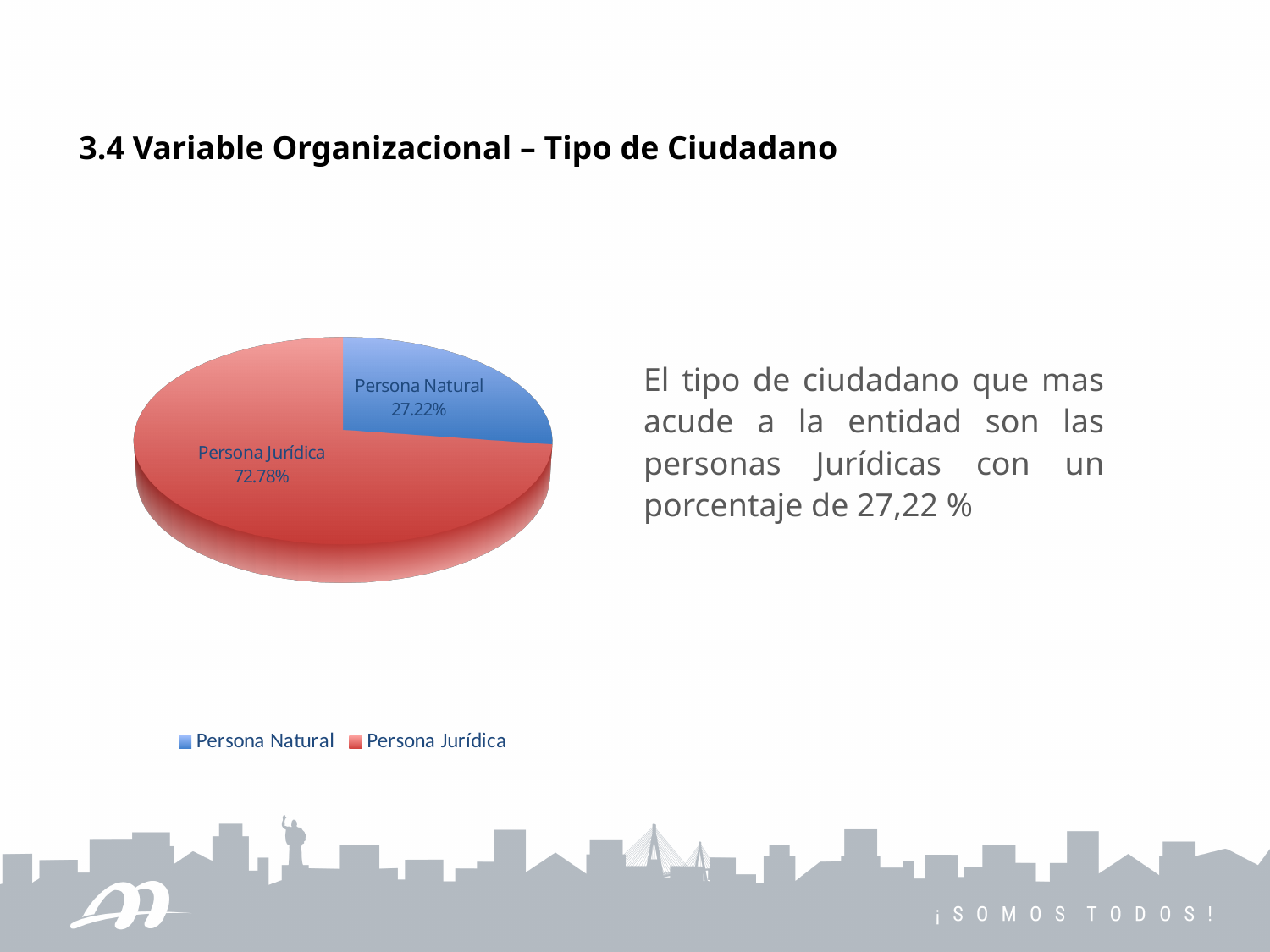
What kind of chart is shown on the slide? Pie chart What share of the pie does Persona Natural represent? 27.22% Which category has the smallest share of the pie? Persona Natural What percentage does the Persona Natural slice show? 27.22% What colour is the Persona Natural slice? Blue Which is larger, the share for Persona Natural or the share for Persona Jurídica? Persona Jurídica Which category has the largest share of the pie? Persona Jurídica What percentage does the Persona Jurídica slice show? 72.78% What is the difference in percentage points between Persona Jurídica and Persona Natural? 45.56 What colour is the Persona Jurídica slice? Red How many entries does the legend list? 2 How many slices does the pie chart have? 2